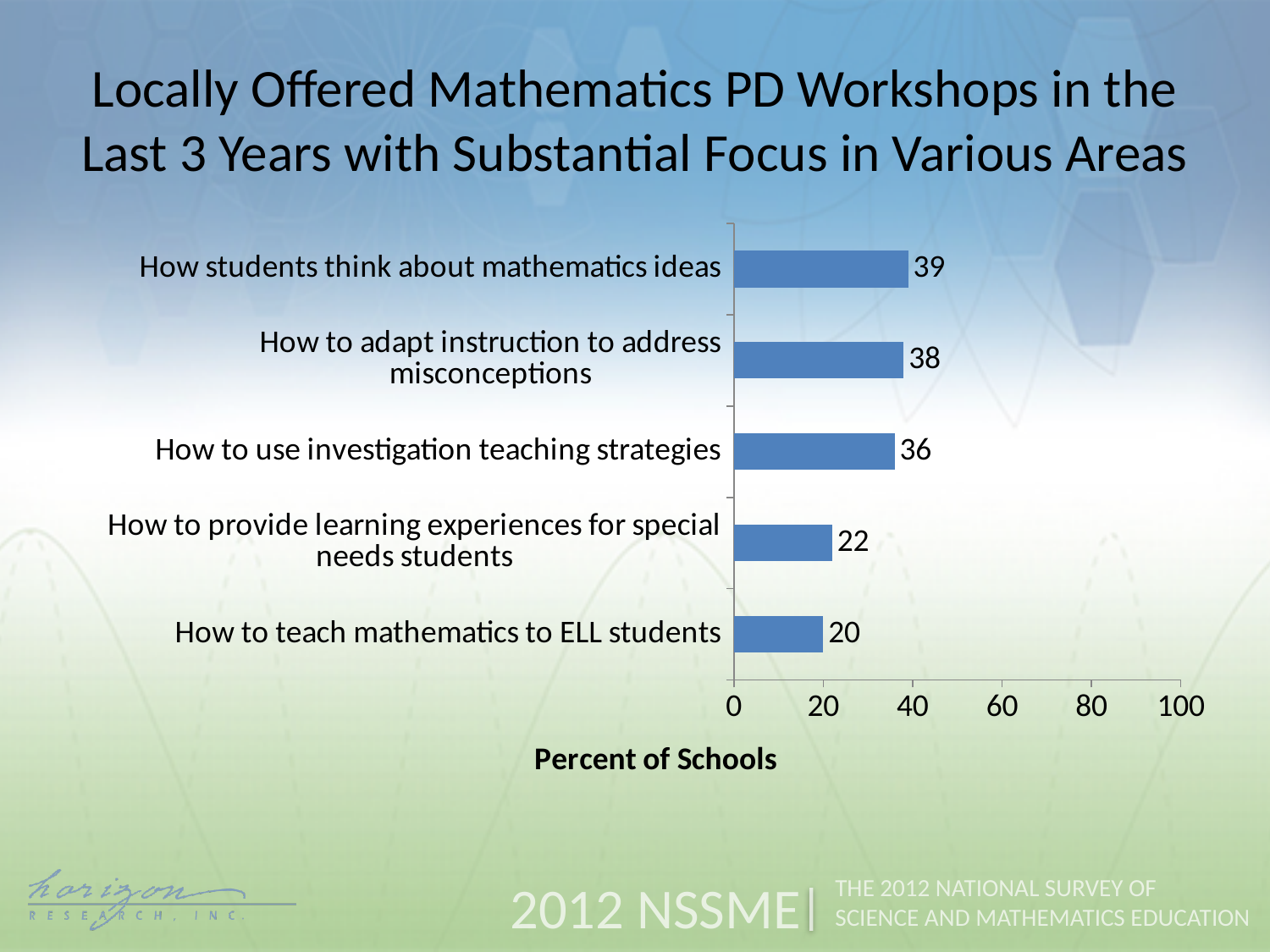
Which is larger: the value for 'How to adapt instruction to address misconceptions' or the value for 'How to provide learning experiences for special needs students'? How to adapt instruction to address misconceptions What percent of schools had locally offered mathematics PD workshops with substantial focus on how students think about mathematics ideas? 39 What is the label of the horizontal axis? Percent of Schools What kind of chart is shown on the slide? Bar chart What is the value for 'How to teach mathematics to ELL students'? 20 Which area has the highest percent of schools? How students think about mathematics ideas How many areas (categories) are shown in the chart? 5 Is the value for 'How to use investigation teaching strategies' greater or less than 40? less Which area has the lowest percent of schools? How to teach mathematics to ELL students What is the value for 'How to provide learning experiences for special needs students'? 22 What is the difference between the values for 'How to use investigation teaching strategies' and 'How to teach mathematics to ELL students'? 16 What is the maximum value shown on the horizontal axis? 100